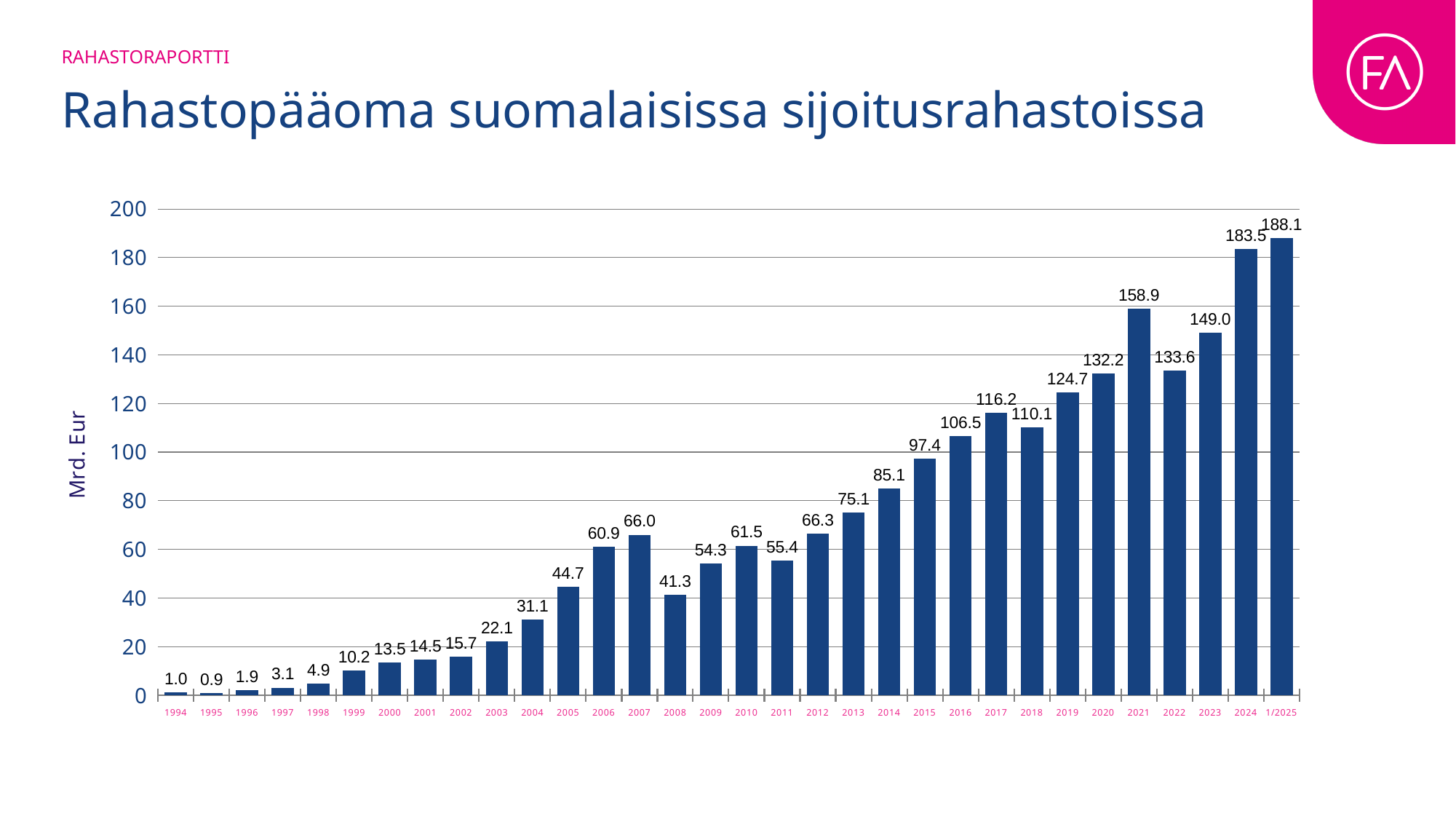
Is the value for 2023 greater or less than 140? greater What is the label on the vertical axis? Mrd. Eur What is the difference between the values for 2021 and 2022? 25.3 What is the value for 2015? 97.4 How many bars are shown in the chart? 32 What is the value for 2008? 41.3 What is the difference between the values for 2007 and 2008? 24.7 Which year has the lowest value? 1995 Which category has the highest value? 1/2025 What kind of chart is shown on the slide? Bar chart What is the value for 1/2025? 188.1 Which is larger, the value for 2017 or the value for 2018? 2017